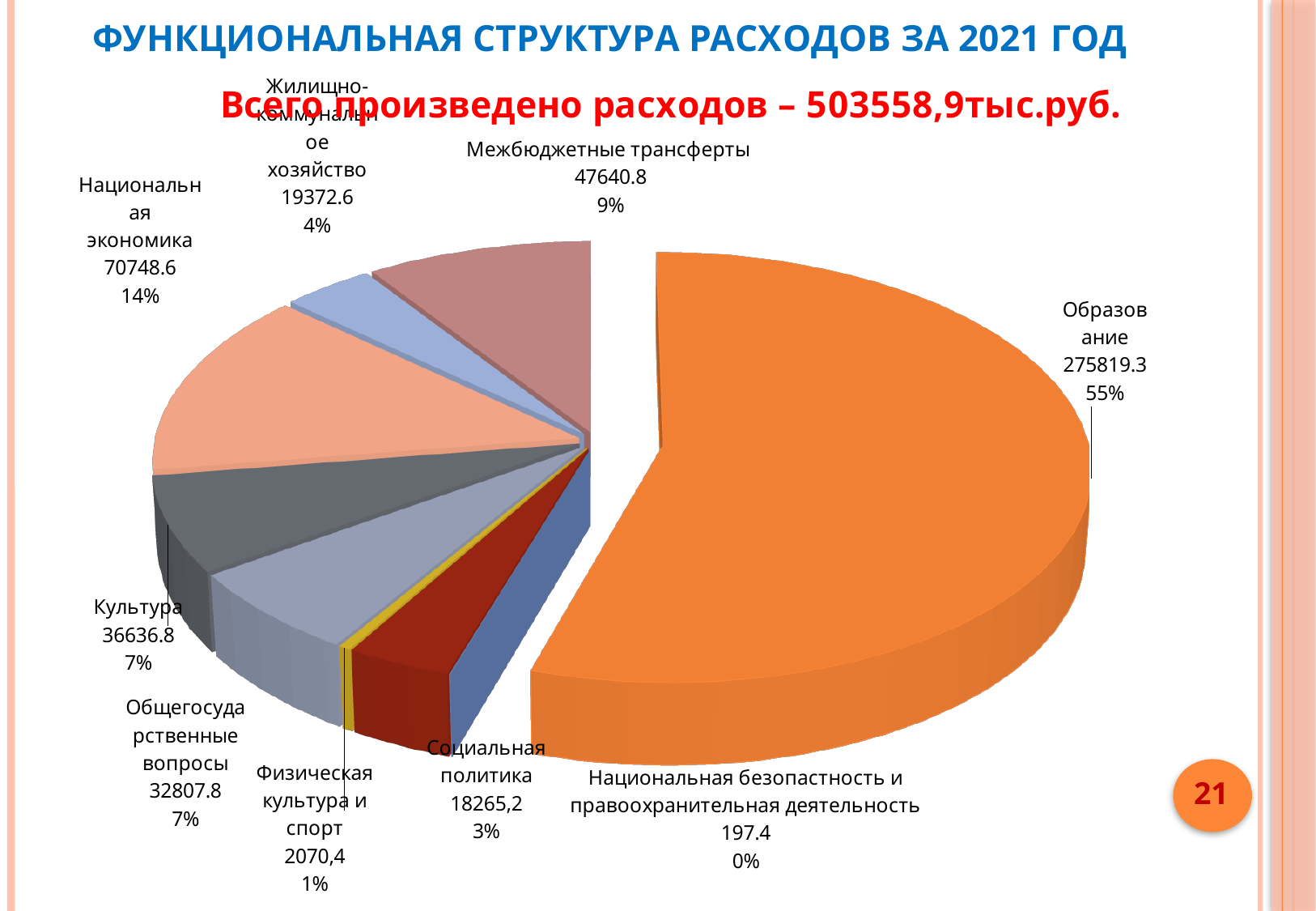
What value is shown for Межбюджетные трансферты? 47640.8 What is the difference between the values for Национальная экономика and Культура? 34111.8 What value is shown for Социальная политика? 18265,2 Which is larger, the value for Культура or the value for Общегосударственные вопросы? Культура What is the difference between the values for Межбюджетные трансферты and Жилищно-коммунальное хозяйство? 28268.2 Which category has the smallest value? Национальная безопастность и правоохранительная деятельность What kind of chart is shown on the slide? Pie chart What value is shown for Образование? 275819.3 Which category has the largest share of the pie? Образование What percentage share of the pie does Образование have? 55% What value is shown for Национальная экономика? 70748.6 How many categories are shown in the pie chart? 9